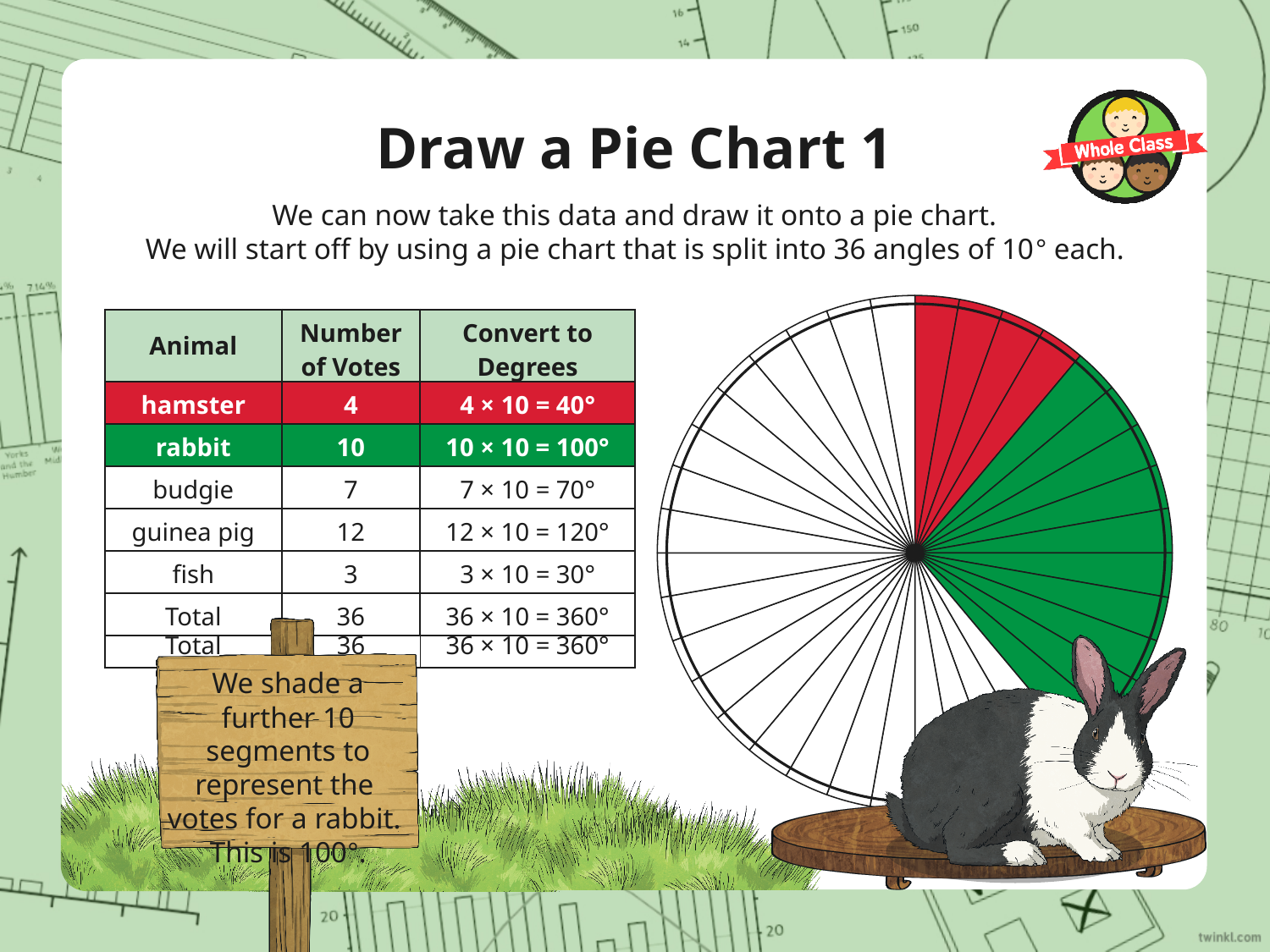
Which received more votes, the budgie or the fish? budgie What is the difference in votes between the rabbit and the hamster? 6 What kind of chart is shown on the right of the slide? pie chart What is the total number of votes? 36 Which animal received the fewest votes? fish How many votes did the rabbit receive? 10 How many degrees does the hamster slice of the pie chart represent? 40° What colour is the rabbit slice shaded on the pie chart? green How many degrees is each segment of the pie chart? 10° How many equal segments is the pie chart split into? 36 How many degrees does the rabbit slice of the pie chart represent? 100° Which animal received the most votes? guinea pig